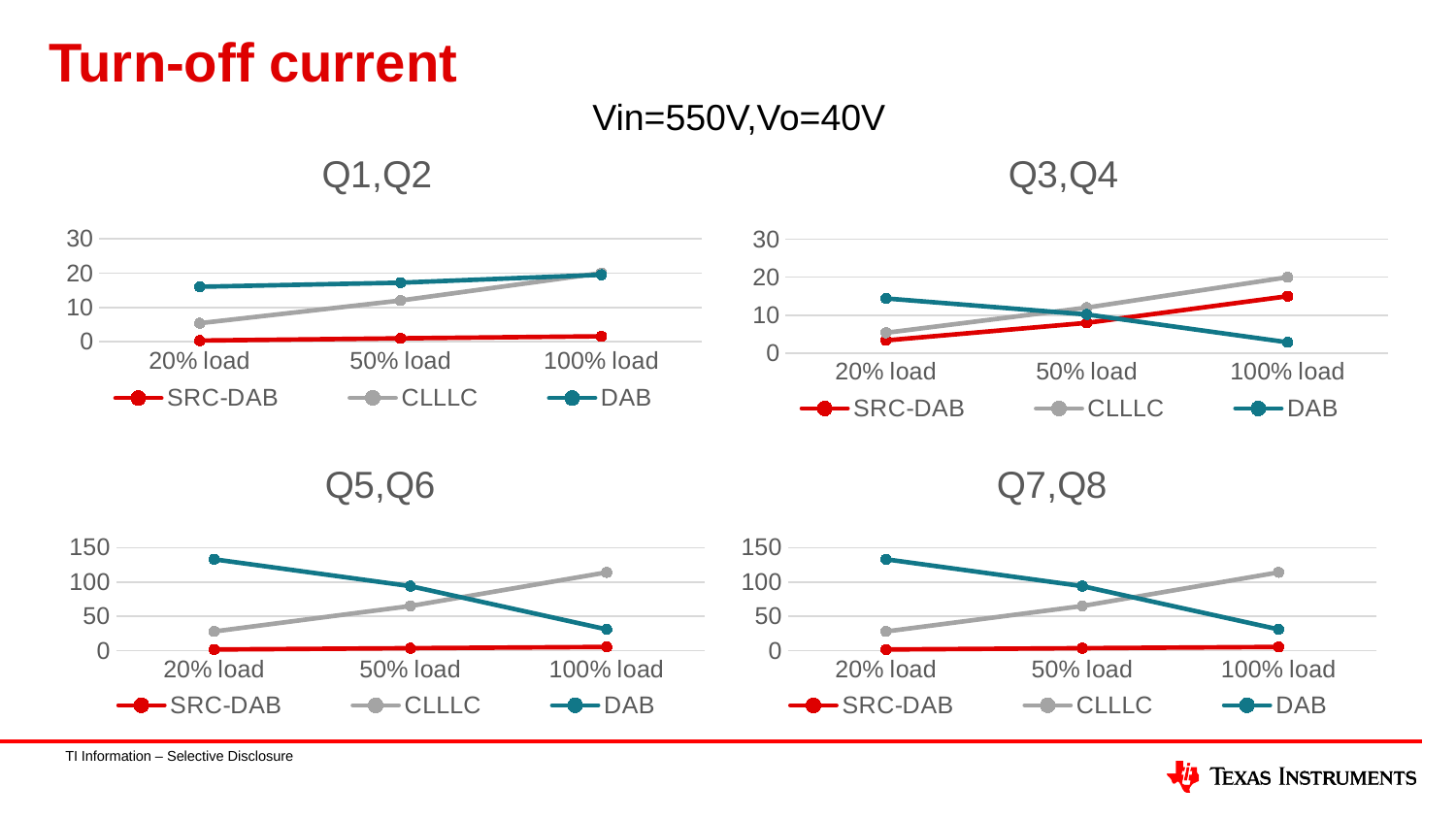
What operating condition is stated above the charts on the slide? Vin=550V,Vo=40V How many series does the legend of the Q1,Q2 chart list? 3 In the Q1,Q2 chart, is the value for DAB at 20% load greater or less than 10? greater What kind of chart is the Q1,Q2 chart? line chart In the Q3,Q4 chart, at 20% load, which is larger: DAB or SRC-DAB? DAB In the Q1,Q2 chart, which series has the lowest value at 20% load? SRC-DAB In the Q3,Q4 chart, which series has the highest value at 100% load? CLLLC In the Q3,Q4 chart, does the DAB series rise or fall from 20% load to 100% load? fall In the Q5,Q6 chart, which series has the highest value at 20% load? DAB In the Q7,Q8 chart, does the CLLLC series rise or fall from 20% load to 100% load? rise In the Q5,Q6 chart, is the value for CLLLC at 100% load greater or less than 100? greater How many load categories are shown on the x axis of the Q1,Q2 chart? 3